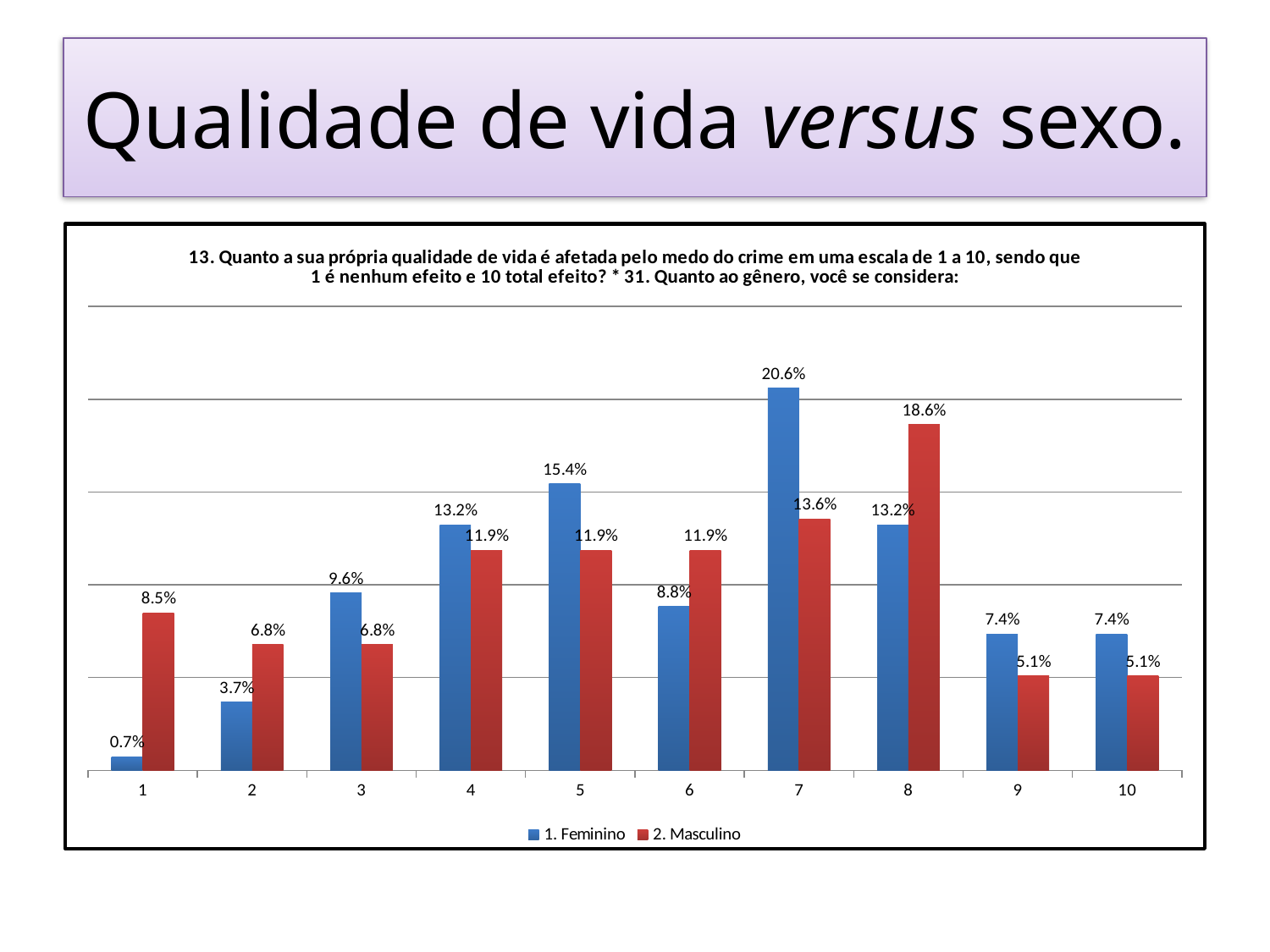
At which scale point is the 1. Feminino value highest? 7 What kind of chart is shown on the slide? Bar chart At which scale point is the 1. Feminino value lowest? 1 How many series does the legend list? 2 How many scale points (categories) are shown on the x axis? 10 What is the value for 2. Masculino at scale point 3? 6.8% What is the value for 1. Feminino at scale point 1? 0.7% What is the difference between the 1. Feminino and 2. Masculino values at scale point 7? 7.0% At scale point 6, which series has the larger value, 1. Feminino or 2. Masculino? 2. Masculino What is the value for 2. Masculino at scale point 8? 18.6% At which scale point is the 2. Masculino value highest? 8 What is the value for 1. Feminino at scale point 7? 20.6%